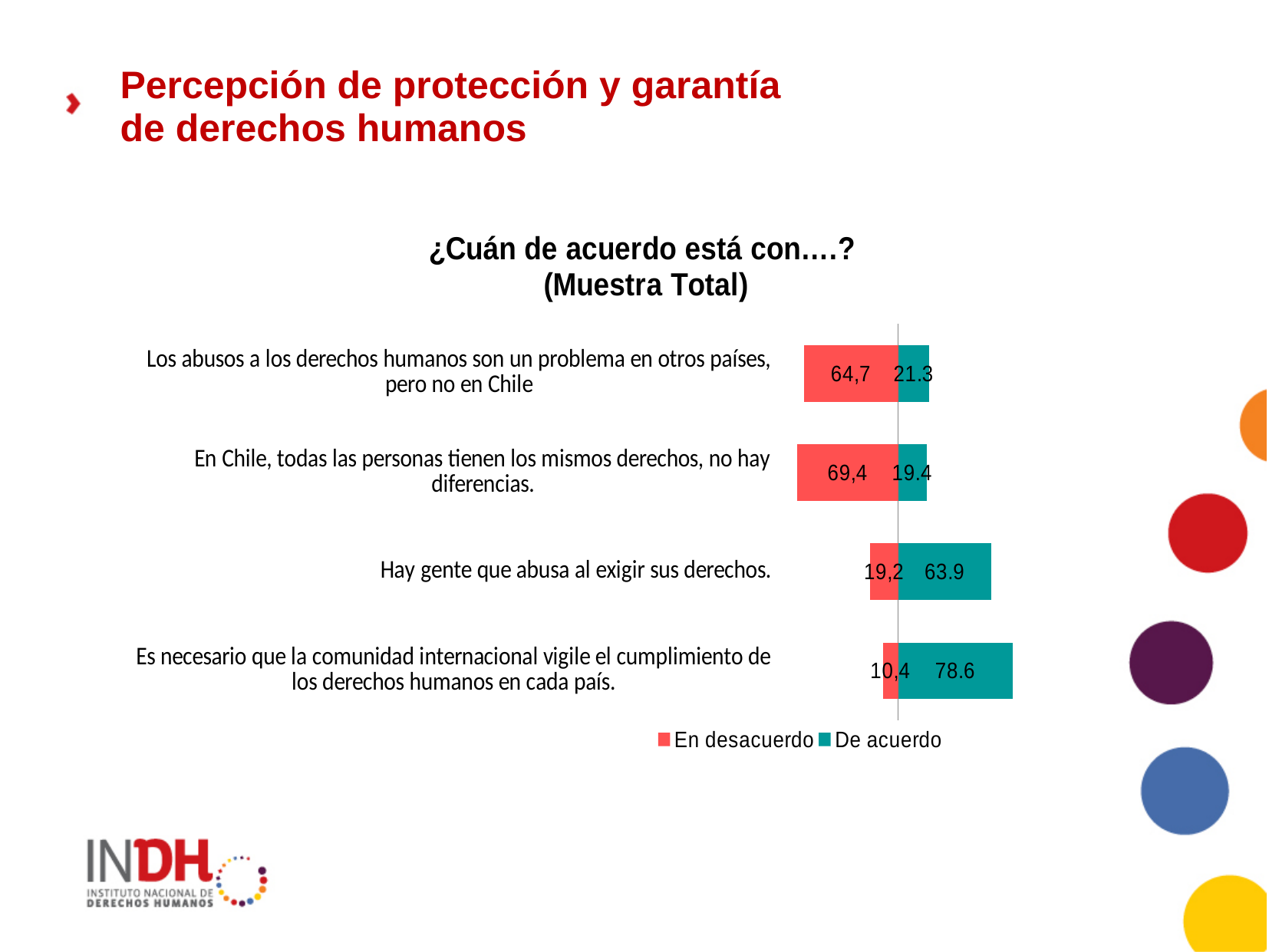
Which statement has the highest 'De acuerdo' value? Es necesario que la comunidad internacional vigile el cumplimiento de los derechos humanos en cada país. How many statements (categories) are shown in the chart? 4 What is the 'De acuerdo' value for 'Es necesario que la comunidad internacional vigile el cumplimiento de los derechos humanos en cada país.'? 78.6 How many series does the legend list? 2 Which statement has the lowest 'En desacuerdo' value? Es necesario que la comunidad internacional vigile el cumplimiento de los derechos humanos en cada país. For 'Los abusos a los derechos humanos son un problema en otros países, pero no en Chile', which is larger: 'En desacuerdo' or 'De acuerdo'? En desacuerdo What is the 'De acuerdo' value for 'Los abusos a los derechos humanos son un problema en otros países, pero no en Chile'? 21.3 Which statement has the highest 'En desacuerdo' value? En Chile, todas las personas tienen los mismos derechos, no hay diferencias. What is the 'En desacuerdo' value for 'Hay gente que abusa al exigir sus derechos.'? 19,2 What is the 'En desacuerdo' value for 'En Chile, todas las personas tienen los mismos derechos, no hay diferencias.'? 69,4 What type of chart is shown on the slide? Bar chart What is the difference between the 'De acuerdo' and 'En desacuerdo' values for 'Hay gente que abusa al exigir sus derechos.'? 44.7